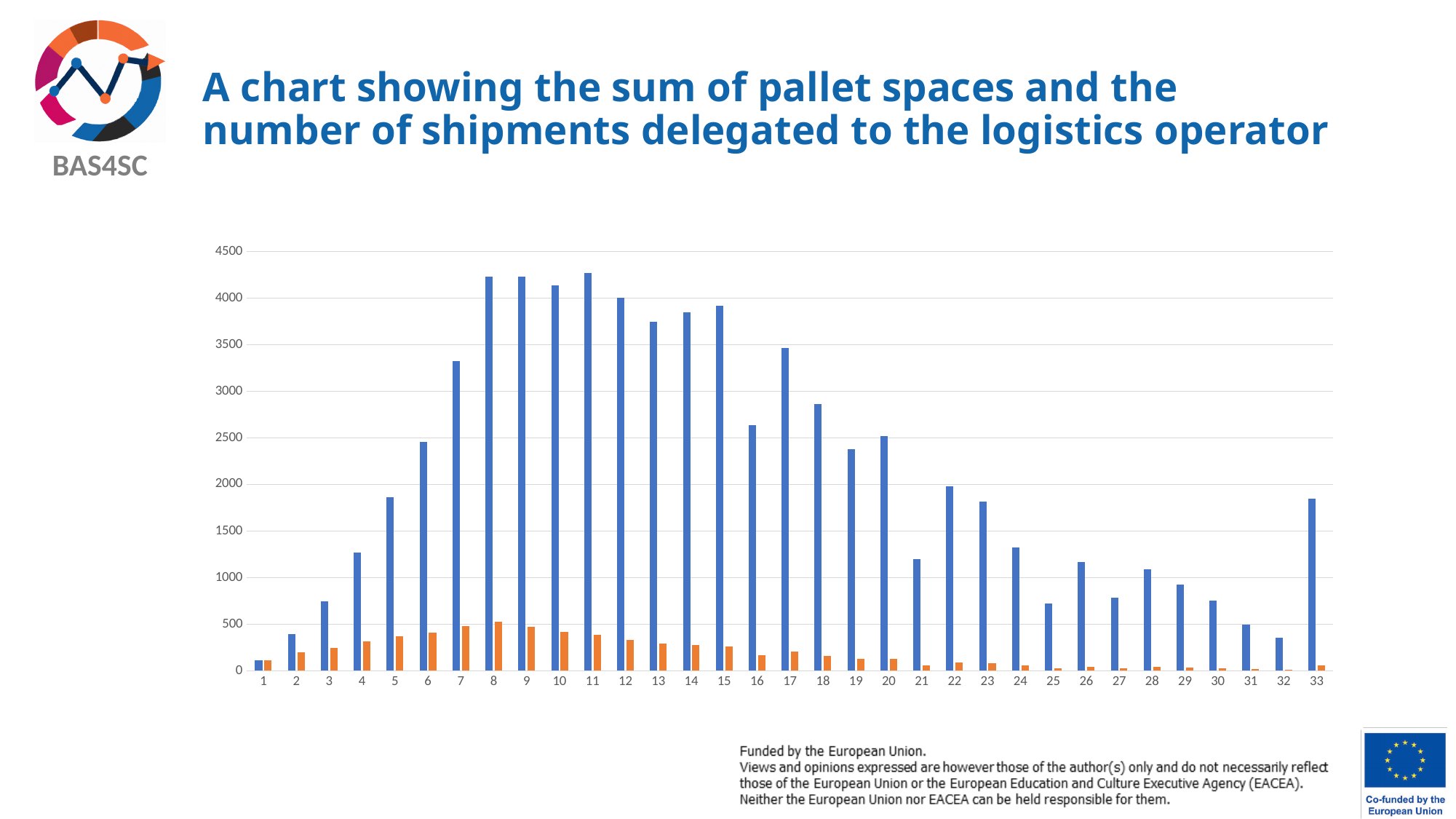
Is the orange bar for category 1 greater or less than 500? less Is the blue bar for category 33 greater or less than 2000? less Do the blue bars rise or fall from category 11 to category 21? fall What is the title of the slide containing the chart? A chart showing the sum of pallet spaces and the number of shipments delegated to the logistics operator Is the blue bar for category 16 greater or less than 2500? greater How many categories are shown along the x axis of the chart? 33 What kind of chart is shown on the slide? bar chart Which has the larger blue bar, category 5 or category 6? 6 How many bar series (colours) are plotted in the chart? 2 Which category has the lowest blue bar in the chart? 1 Which category has the highest orange bar in the chart? 8